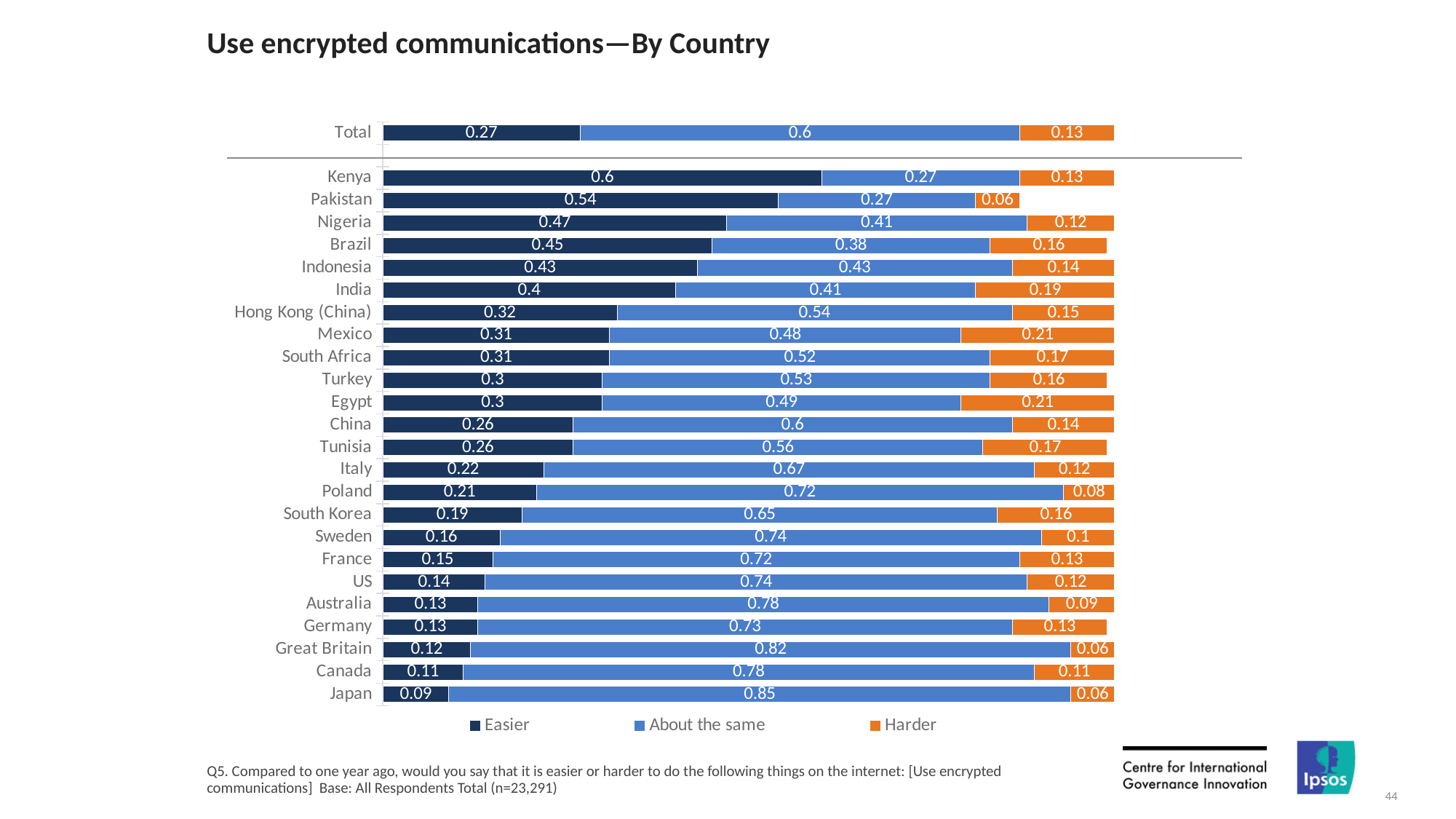
What is the 'Harder' value for the Total bar? 0.13 How many series does the legend list? 3 What is the 'Harder' value for Mexico? 0.21 Which country has the highest 'Easier' value? Kenya What kind of chart is shown on the slide? Stacked bar chart How many countries are shown in the chart, excluding the Total bar? 24 Which has a larger 'Harder' value, India or Italy? India What is the 'About the same' value for Japan? 0.85 What is the 'Easier' value for Kenya? 0.6 Which country has the highest 'About the same' value? Japan What is the difference between the 'Easier' values for Kenya and Japan? 0.51 Which country has the lowest 'Easier' value? Japan